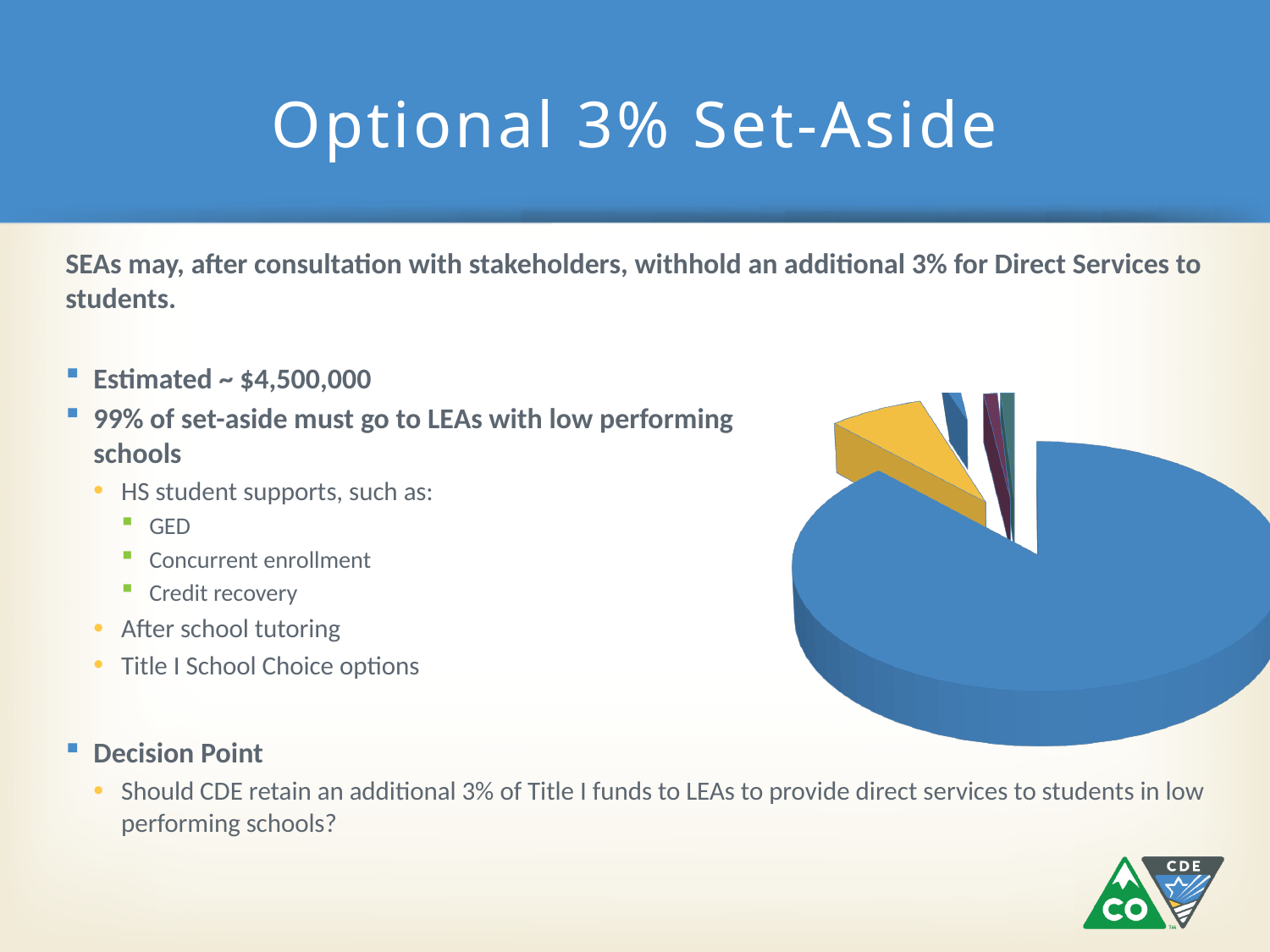
Is the pie chart drawn in 3D? Yes Does the pie chart have a legend? No What kind of chart is shown on the slide? pie chart Which colour slice takes up the largest share of the pie chart? blue